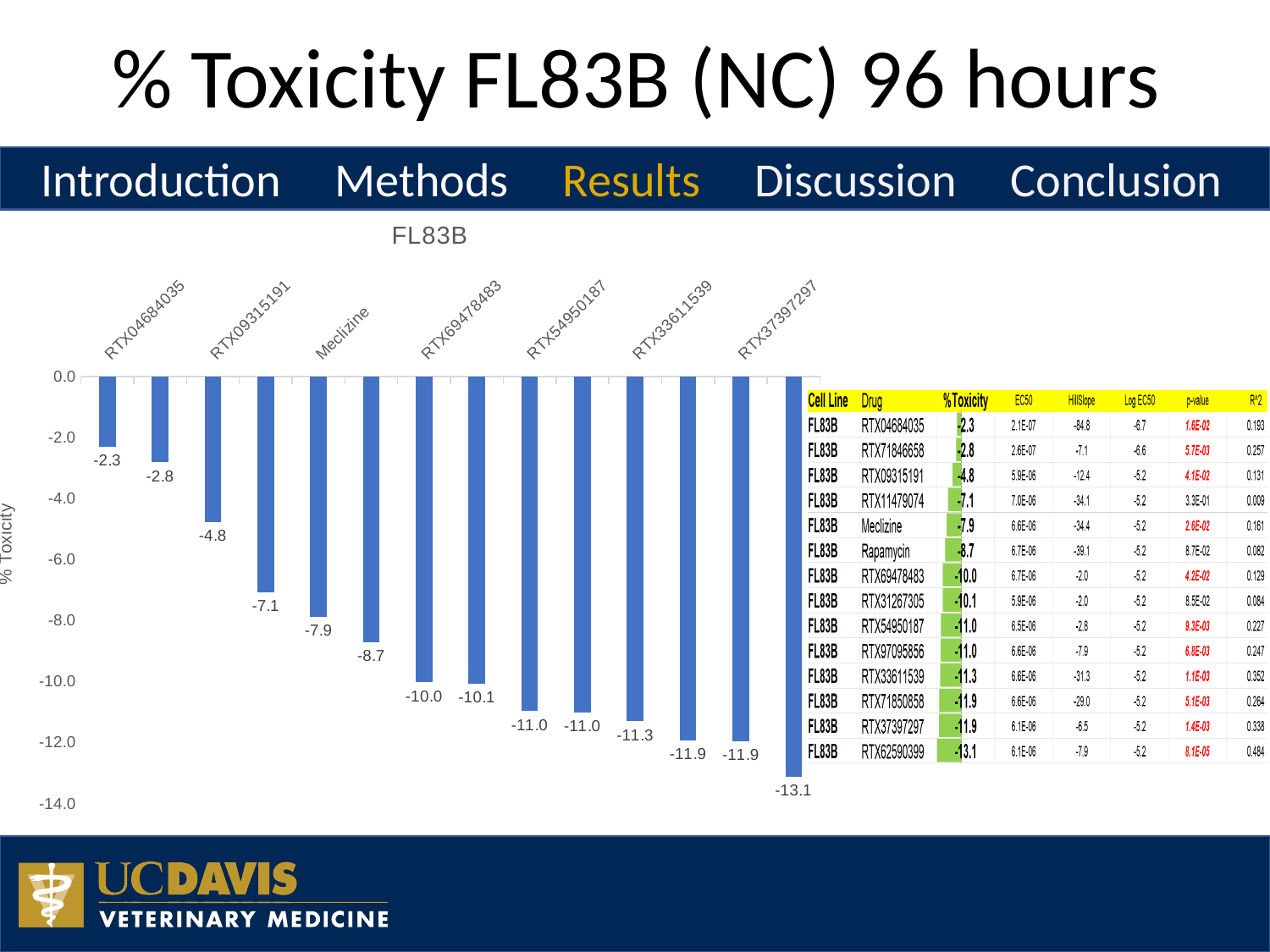
Which labelled category has the highest value in the FL83B chart? RTX04684035 How many bars are plotted in the FL83B chart? 14 Which has the larger value in the FL83B chart, RTX54950187 or RTX33611539? RTX54950187 What is the lowest value shown in the FL83B chart? -13.1 What is the difference between the values for RTX09315191 and Meclizine in the FL83B chart? 3.1 What is the value shown for RTX69478483 in the FL83B chart? -10.0 Do the values in the FL83B chart rise or fall from left to right? fall What is the value shown for RTX33611539 in the FL83B chart? -11.3 What is the value shown for RTX04684035 in the FL83B chart? -2.3 What kind of chart is the FL83B chart? bar chart What is the label on the vertical axis of the FL83B chart? % Toxicity What is the % Toxicity value for Meclizine in the FL83B chart? -7.9